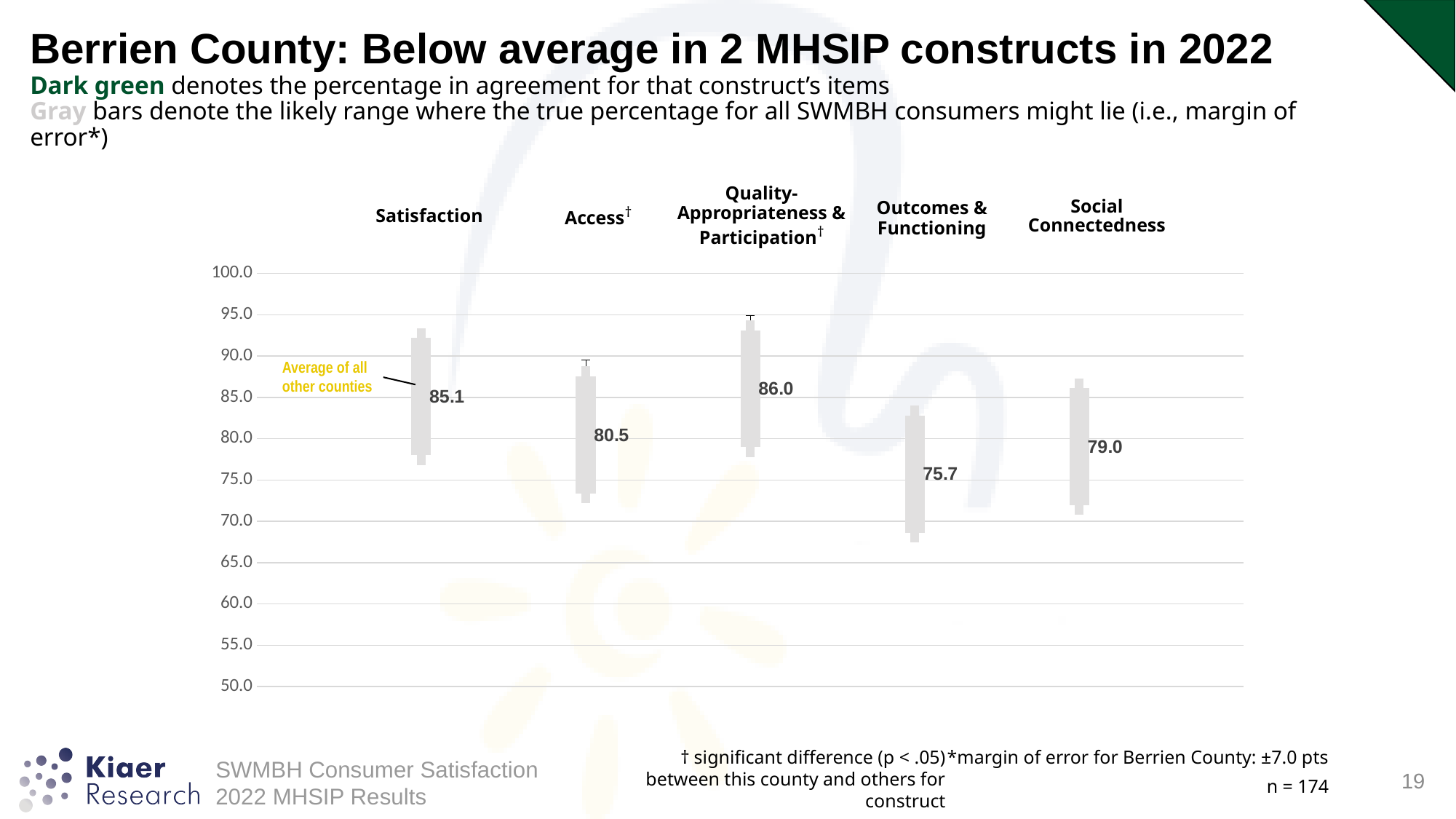
What value is labelled for Outcomes & Functioning on the chart? 75.7 How many constructs are shown on the chart? 5 What value is labelled for Access on the chart? 80.5 What value is labelled for Quality-Appropriateness & Participation on the chart? 86.0 What is the lowest value shown on the chart's vertical axis? 50.0 What is the difference between the labelled values for Satisfaction and Access? 4.6 Which construct has the highest labelled value on the chart? Quality-Appropriateness & Participation According to the slide, what is the margin of error for Berrien County? ±7.0 pts What value is labelled for Satisfaction on the chart? 85.1 Which has a larger labelled value, Social Connectedness or Outcomes & Functioning? Social Connectedness What value is labelled for Social Connectedness on the chart? 79.0 Which construct has the lowest labelled value on the chart? Outcomes & Functioning